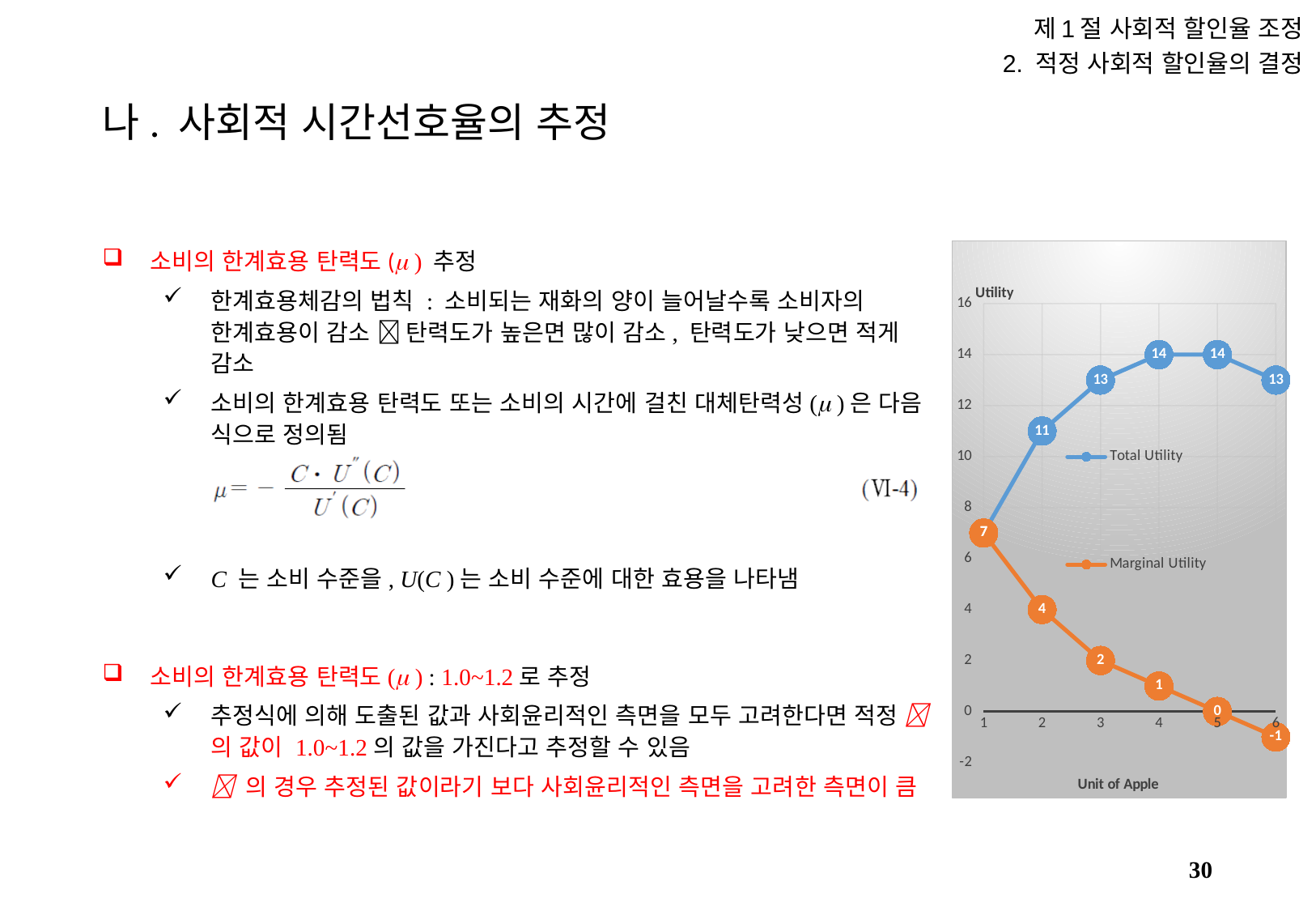
At which unit of apple is Marginal Utility lowest? 6 What is the Total Utility at 2 units of apple? 11 How many series does the chart legend list? 2 How many units of apple are plotted on the x axis? 6 What is the difference between Total Utility at 3 units and Total Utility at 2 units? 2 What is the label of the x axis? Unit of Apple What is the Total Utility at 4 units of apple? 14 What is the Marginal Utility at 3 units of apple? 2 Which is larger at 4 units of apple: Total Utility or Marginal Utility? Total Utility Does Marginal Utility rise or fall as the unit of apple increases? fall What type of chart is shown on the slide? line chart What is the Marginal Utility at 6 units of apple? -1